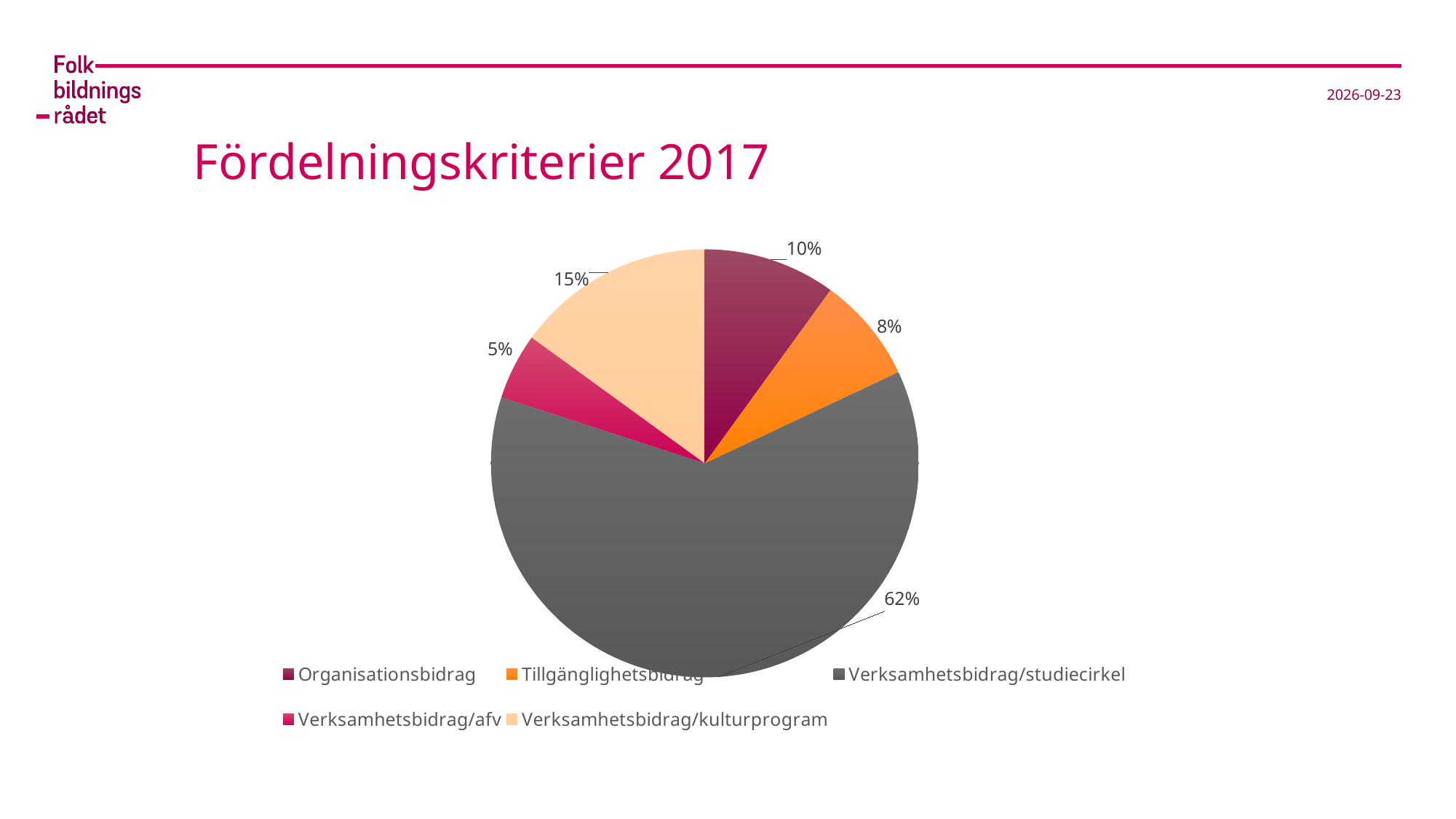
Which category has the smallest slice of the pie? Verksamhetsbidrag/afv Which category has the largest slice of the pie? Verksamhetsbidrag/studiecirkel How many slices does the pie chart have? 5 What share of the pie does Verksamhetsbidrag/studiecirkel have? 62% What kind of chart is shown on the slide? pie chart What is the difference in percentage points between Verksamhetsbidrag/kulturprogram and Organisationsbidrag? 5 What share of the pie does Organisationsbidrag have? 10% What share of the pie does Tillgänglighetsbidrag have? 8% What is the title of the slide containing the pie chart? Fördelningskriterier 2017 Which is larger, the slice for Organisationsbidrag or the slice for Tillgänglighetsbidrag? Organisationsbidrag